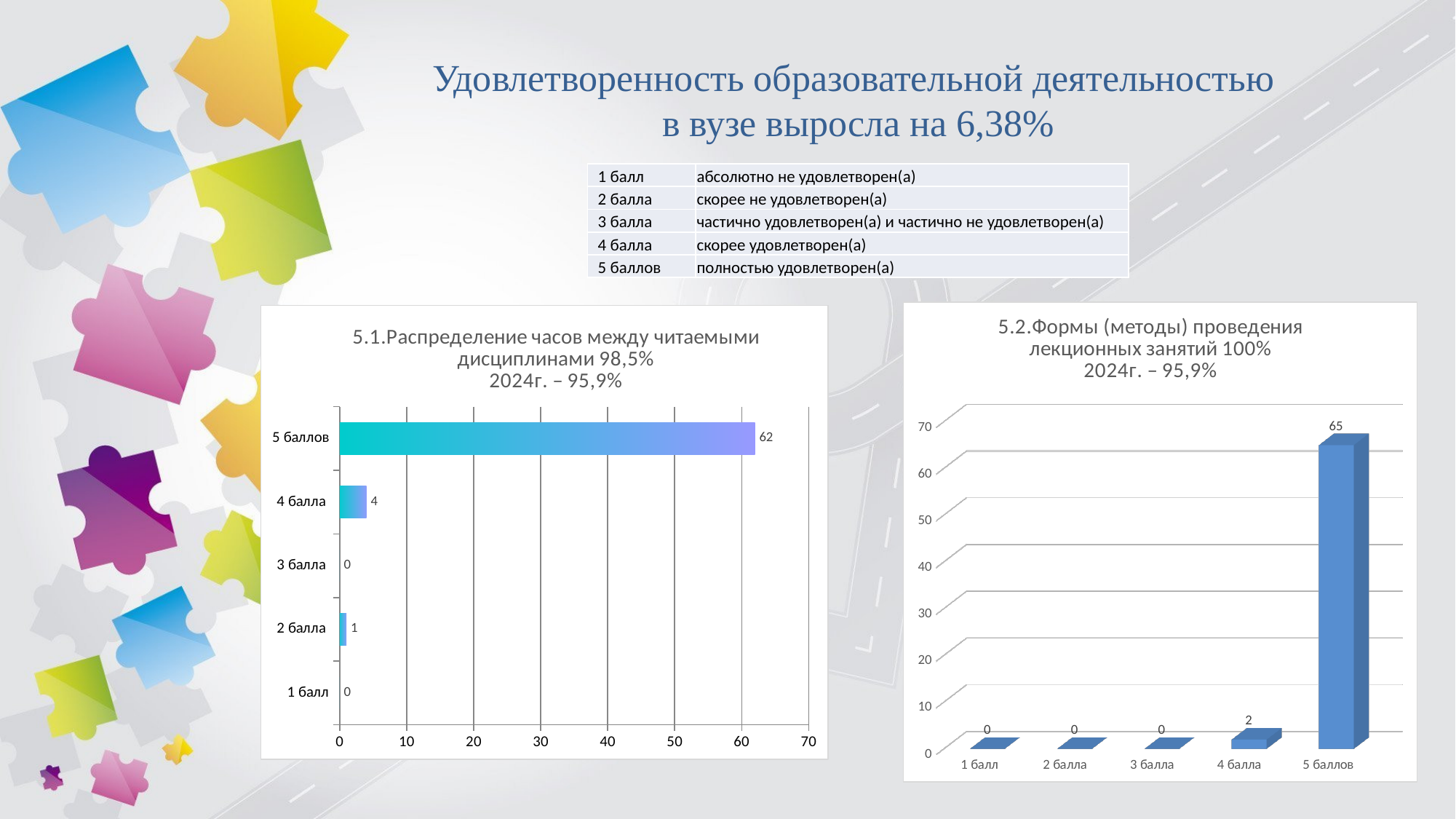
In the chart '5.2.Формы (методы) проведения лекционных занятий', what is the value for '4 балла'? 2 In the chart '5.2.Формы (методы) проведения лекционных занятий', what is the difference between the values for '5 баллов' and '4 балла'? 63 In the chart '5.1.Распределение часов между читаемыми дисциплинами', what is the value for '5 баллов'? 62 In the chart '5.1.Распределение часов между читаемыми дисциплинами', what is the difference between the values for '5 баллов' and '4 балла'? 58 In the chart '5.1.Распределение часов между читаемыми дисциплинами', what is the value for '2 балла'? 1 In the chart '5.2.Формы (методы) проведения лекционных занятий', how many categories have a value of 0? 3 In the chart '5.1.Распределение часов между читаемыми дисциплинами', how many categories are shown on the vertical axis? 5 In the chart '5.1.Распределение часов между читаемыми дисциплинами', which category has the highest value? 5 баллов In the chart '5.2.Формы (методы) проведения лекционных занятий', which is larger: the value for '4 балла' or the value for '5 баллов'? 5 баллов In the chart '5.2.Формы (методы) проведения лекционных занятий', what is the value for '5 баллов'? 65 What kind of chart is '5.1.Распределение часов между читаемыми дисциплинами'? Bar chart In the chart '5.1.Распределение часов между читаемыми дисциплинами', what is the value for '4 балла'? 4